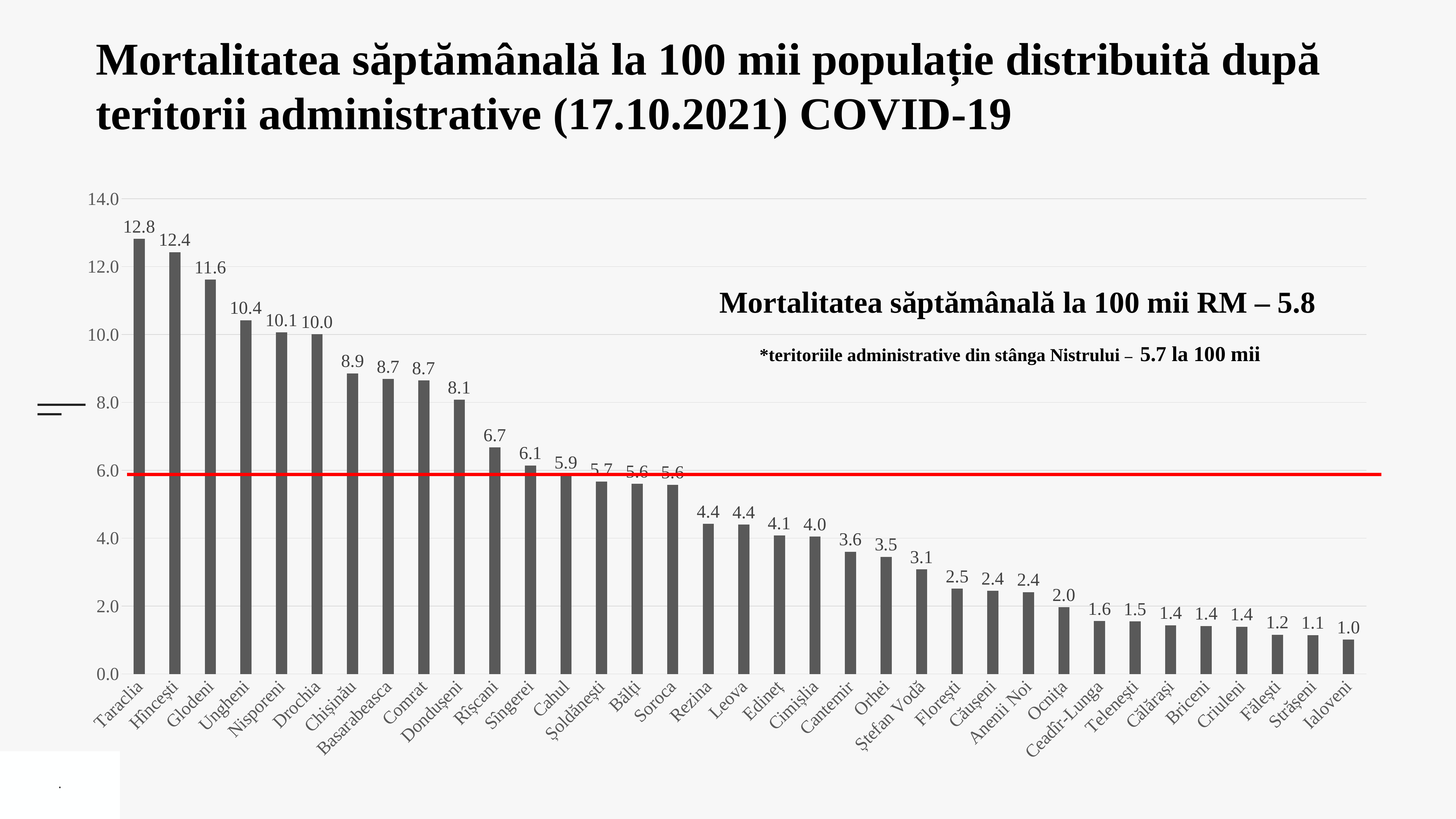
Which territory has the lowest weekly mortality? Ialoveni How many territories are shown on the chart? 35 What is the value shown for Bălți? 5.6 What kind of chart is shown on the slide? Bar chart What is the weekly mortality value for Taraclia? 12.8 Which territory has the highest weekly mortality? Taraclia What is the value shown for Chișinău? 8.9 What is the difference between the values for Glodeni and Ungheni? 1.2 Is the value for Dondușeni greater or less than 8.0? greater Which has a higher value, Cahul or Rezina? Cahul What is the difference between the values for Taraclia and Hîncești? 0.4 What is the weekly mortality per 100 thousand for RM stated on the slide? 5.8